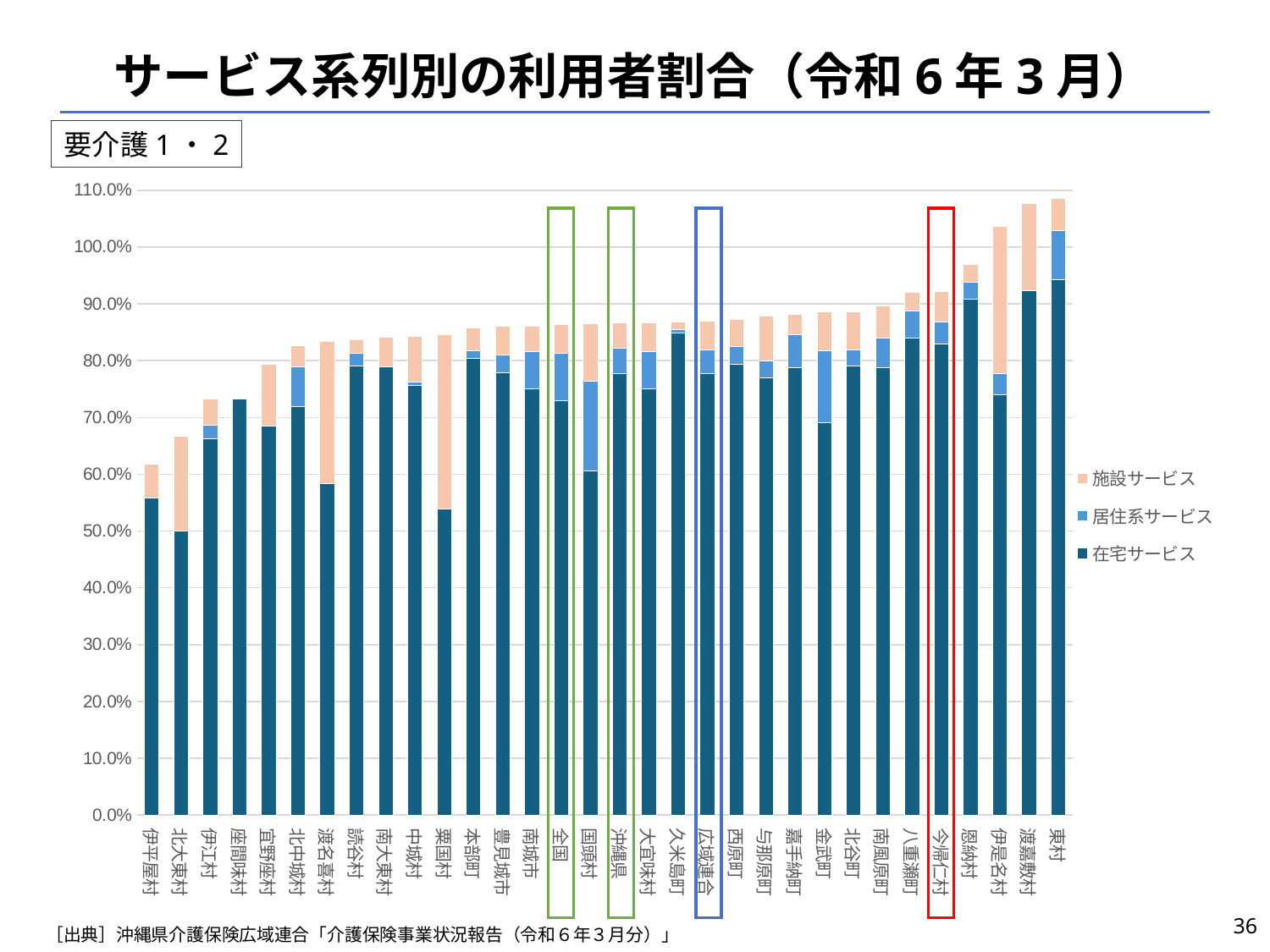
Which category has the highest 在宅サービス value? 東村 Which legend entry is shown in the darkest blue colour? 在宅サービス Is the 在宅サービス value for 伊平屋村 greater or less than 50.0%? greater How many categories are plotted along the x axis? 32 Is the 在宅サービス value for 東村 greater or less than 90.0%? greater Which category has the lowest 在宅サービス value? 北大東村 Is the 在宅サービス value for 久米島町 greater or less than 80.0%? greater What kind of chart is shown on the slide? Stacked bar chart Which category has the lowest total stacked bar? 伊平屋村 How many series does the legend list? 3 Do the total stacked bar heights generally rise or fall from left to right along the x axis? Rise